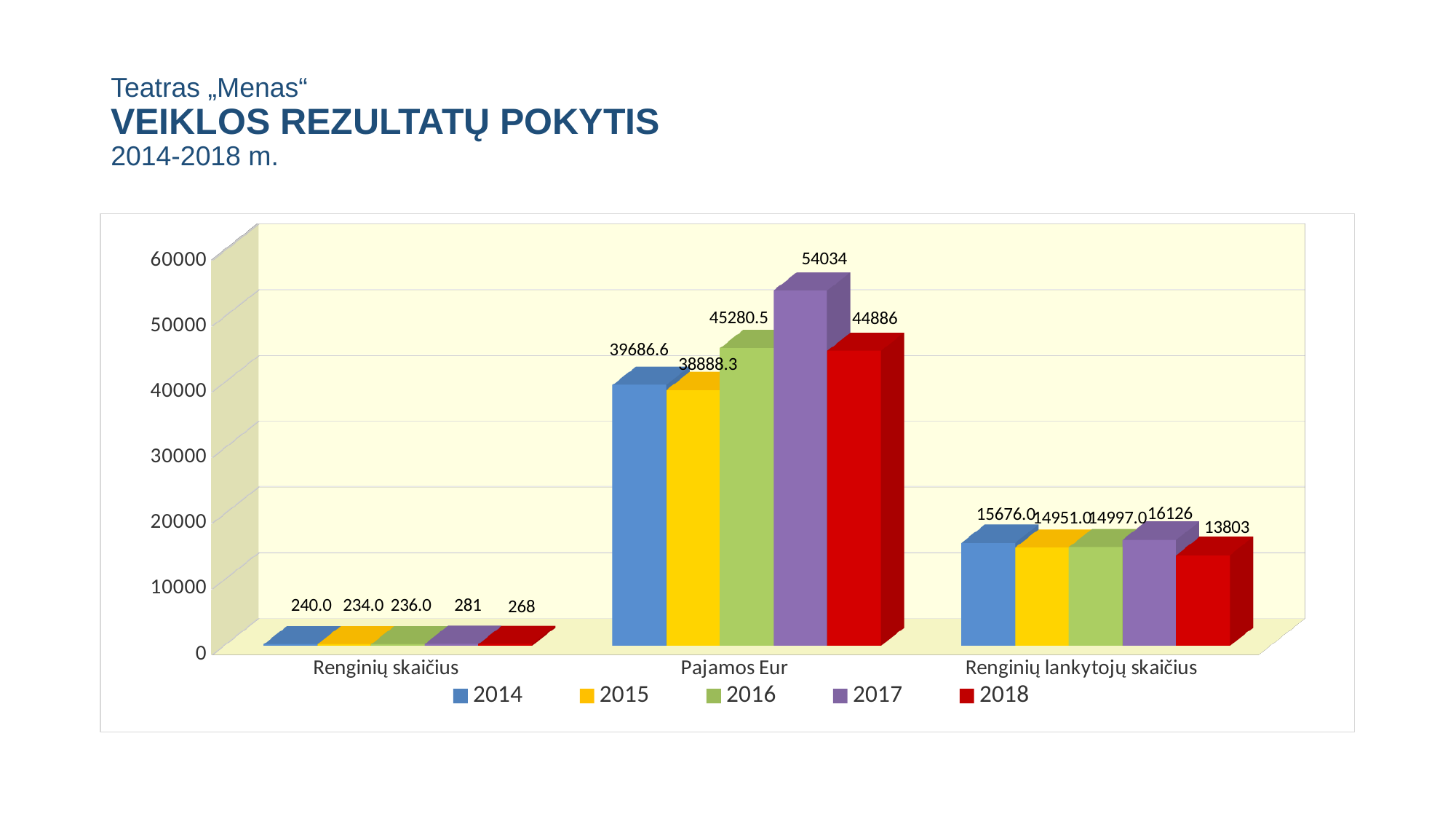
Which year has the lowest value in the Renginių lankytojų skaičius category? 2018 What is the difference between the 2017 and 2018 values in the Pajamos Eur category? 9148 Which colour represents the 2017 series in the legend? purple Is the value for 2016 in the Pajamos Eur category greater or less than 40000? greater How many series does the legend list? 5 What is the value for 2017 in the Pajamos Eur category? 54034 How many categories are shown on the x axis? 3 What is the value for 2014 in the Renginių skaičius category? 240.0 What kind of chart is shown on the slide? bar chart What is the value for 2018 in the Renginių lankytojų skaičius category? 13803 Which year has the highest value in the Pajamos Eur category? 2017 Which is larger in the Renginių skaičius category: the value for 2017 or the value for 2018? 2017